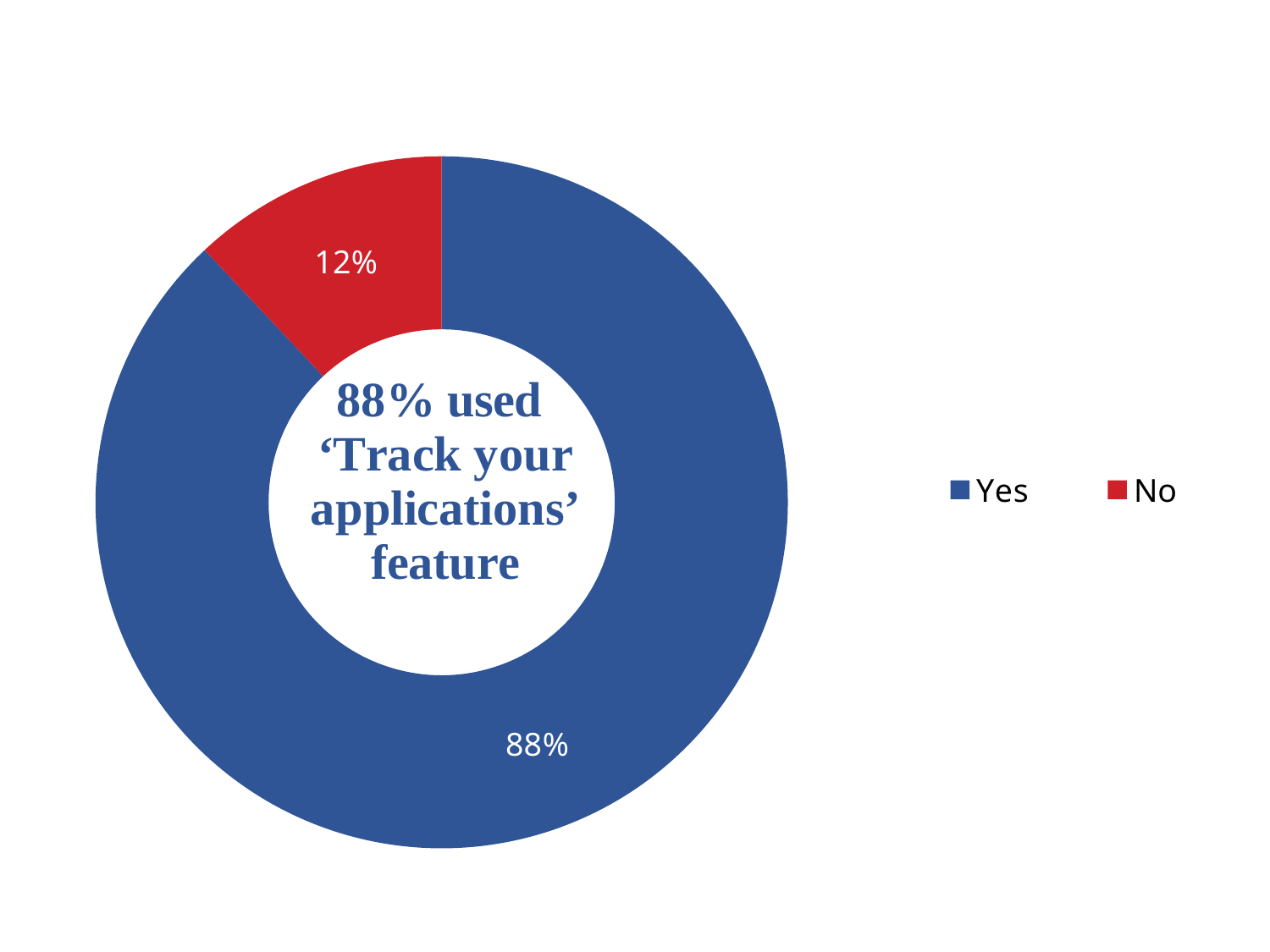
How many categories are shown in the chart? 2 Which category has the largest share of the chart? Yes What text is written in the centre of the doughnut chart? 88% used 'Track your applications' feature What colour is the 'Yes' slice? Blue Which category has the smallest share of the chart? No What kind of chart is shown on the slide? Doughnut (pie) chart What share of the chart does the 'No' slice represent? 12% Which is larger, the 'Yes' share or the 'No' share? Yes What is the difference in percentage points between the 'Yes' and 'No' shares? 76 How many entries does the legend list? 2 What percentage of respondents answered 'No'? 12% What percentage of respondents answered 'Yes'? 88%